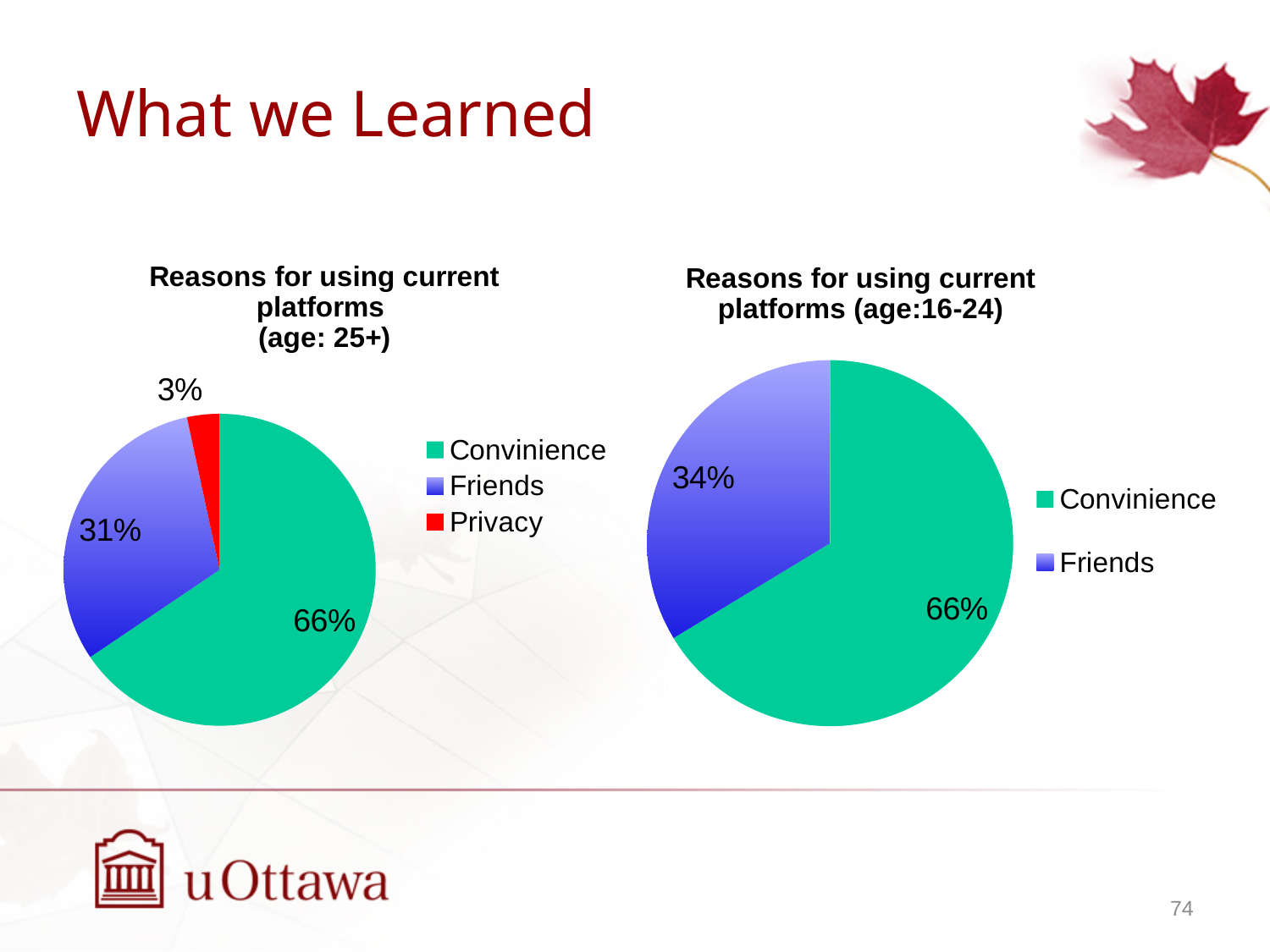
In the 'Reasons for using current platforms (age: 25+)' chart, what share is labelled for Friends? 31% In the 'Reasons for using current platforms (age: 25+)' chart, which category has the smallest slice? Privacy How many categories does the legend of the 'Reasons for using current platforms (age: 25+)' chart list? 3 In the 'Reasons for using current platforms (age:16-24)' chart, what share is labelled for Friends? 34% In the 'Reasons for using current platforms (age: 25+)' chart, what share is labelled for Privacy? 3% In the 'Reasons for using current platforms (age:16-24)' chart, what is the difference between the Convinience and Friends shares? 32% In the 'Reasons for using current platforms (age: 25+)' chart, what is the difference between the Convinience and Friends shares? 35% What kind of chart is the 'Reasons for using current platforms (age:16-24)' chart? Pie chart In the 'Reasons for using current platforms (age:16-24)' chart, what share is labelled for Convinience? 66% How many categories does the legend of the 'Reasons for using current platforms (age:16-24)' chart list? 2 In the 'Reasons for using current platforms (age: 25+)' chart, what share is labelled for Convinience? 66% In the 'Reasons for using current platforms (age:16-24)' chart, which category has the largest slice? Convinience